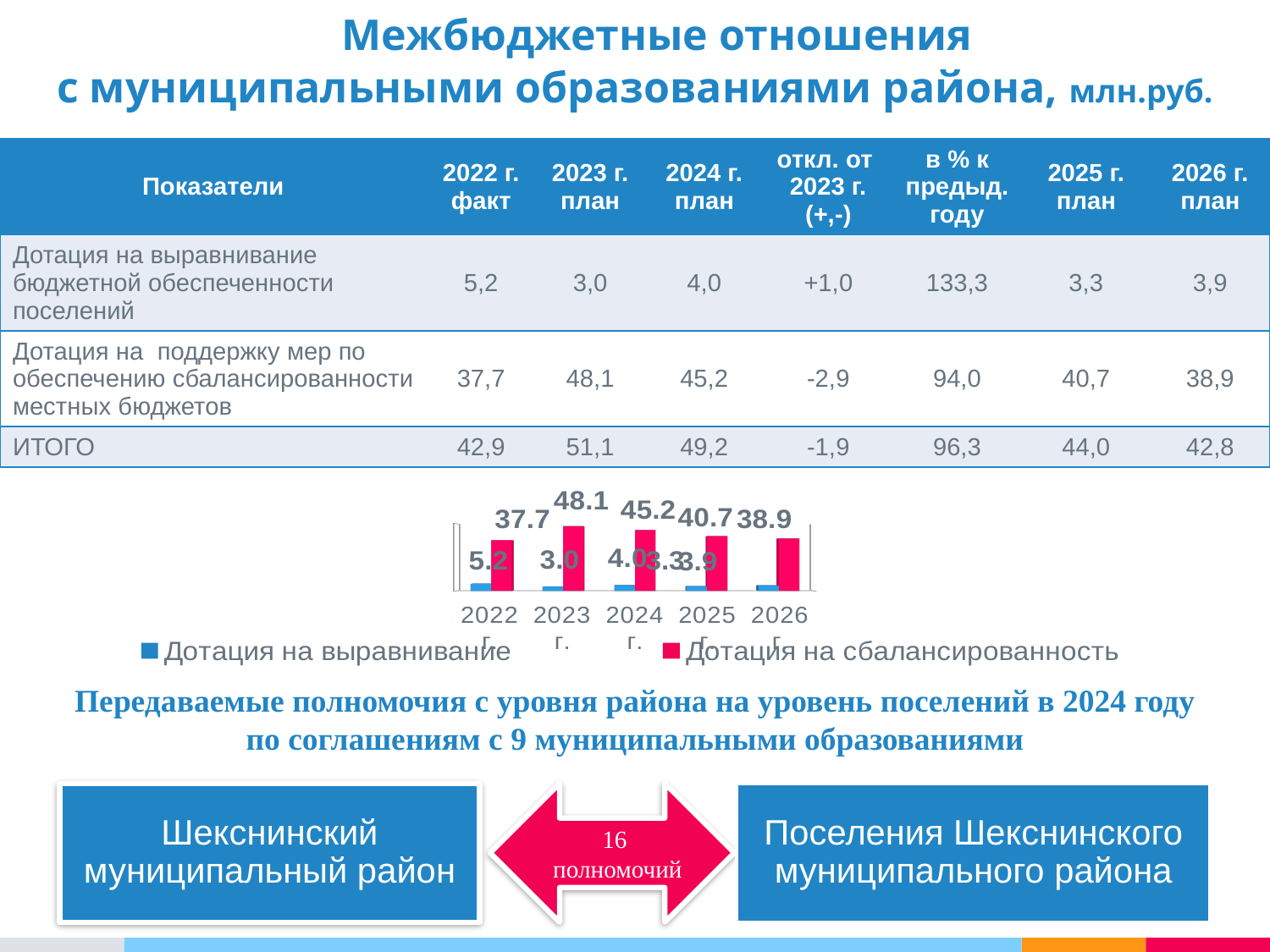
What is the value of Дотация на сбалансированность for 2026 in the chart? 38.9 What is the difference between Дотация на сбалансированность in 2023 and 2024 in the chart? 2.9 What is the value of Дотация на выравнивание for 2022 in the chart? 5.2 What is the value of Дотация на сбалансированность for 2023 in the chart? 48.1 In which year is Дотация на сбалансированность highest in the chart? 2023 How many years are shown on the x axis of the chart? 5 Does Дотация на сбалансированность rise or fall from 2023 to 2026 in the chart? fall Which is larger in the chart: Дотация на сбалансированность in 2024 or in 2025? 2024 Which colour represents Дотация на сбалансированность in the chart? red In which year is Дотация на сбалансированность lowest in the chart? 2022 How many series does the chart legend list? 2 What kind of chart is shown on the slide? bar chart